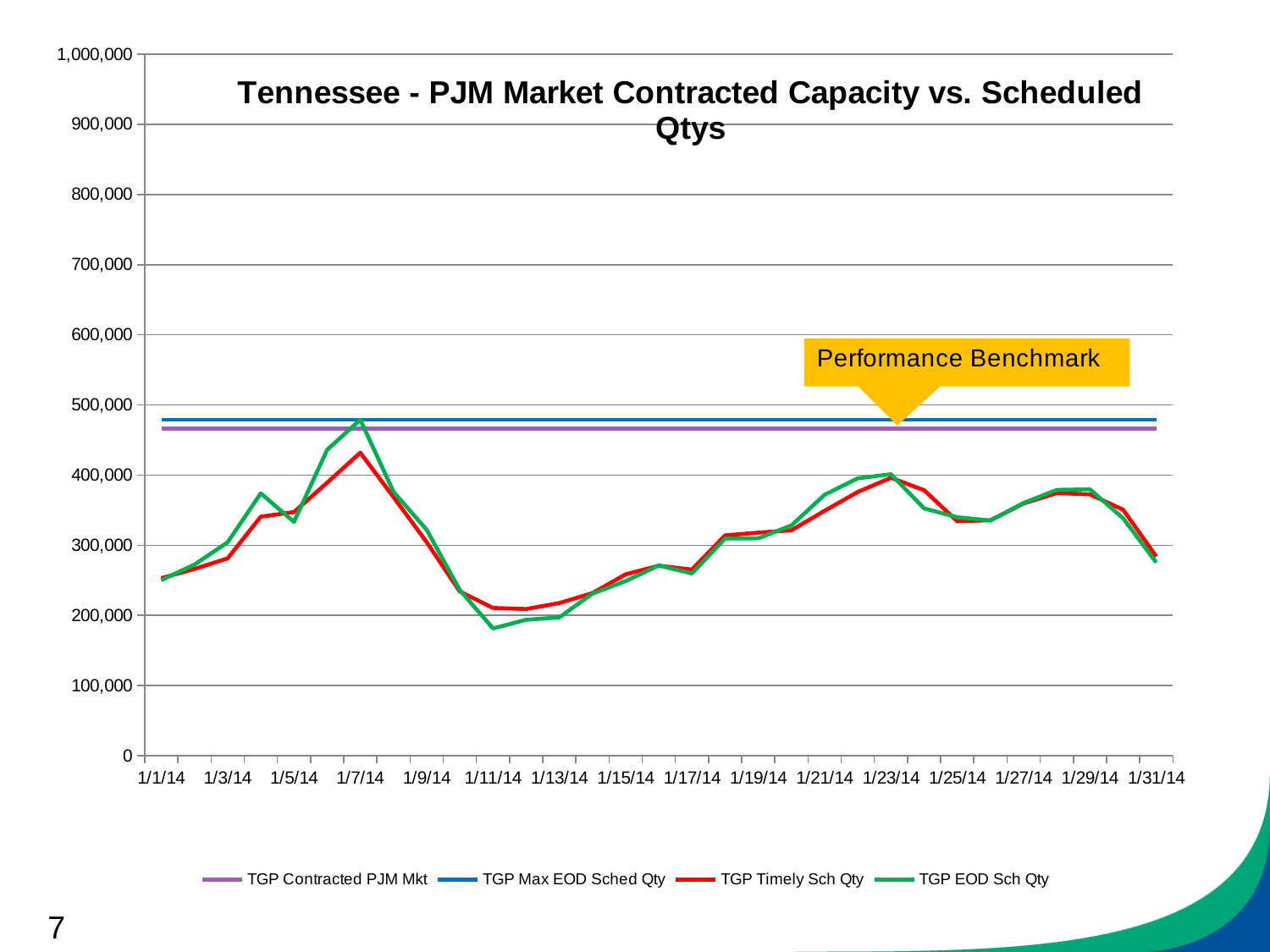
Is the value for TGP Timely Sch Qty on 1/7/14 greater or less than 400,000? greater Is the value for TGP EOD Sch Qty on 1/23/14 greater or less than 300,000? greater What kind of chart is shown on the slide? line chart What is the title of the chart? Tennessee - PJM Market Contracted Capacity vs. Scheduled Qtys Which is higher for TGP EOD Sch Qty, the value on 1/7/14 or the value on 1/11/14? 1/7/14 Which is higher, TGP Max EOD Sched Qty or TGP Contracted PJM Mkt? TGP Max EOD Sched Qty On which date does TGP EOD Sch Qty reach its highest value? 1/7/14 What text is shown in the yellow callout on the chart? Performance Benchmark How many series does the legend list? 4 Is the value for TGP Contracted PJM Mkt greater or less than 500,000? less Does TGP EOD Sch Qty rise or fall between 1/7/14 and 1/11/14? fall